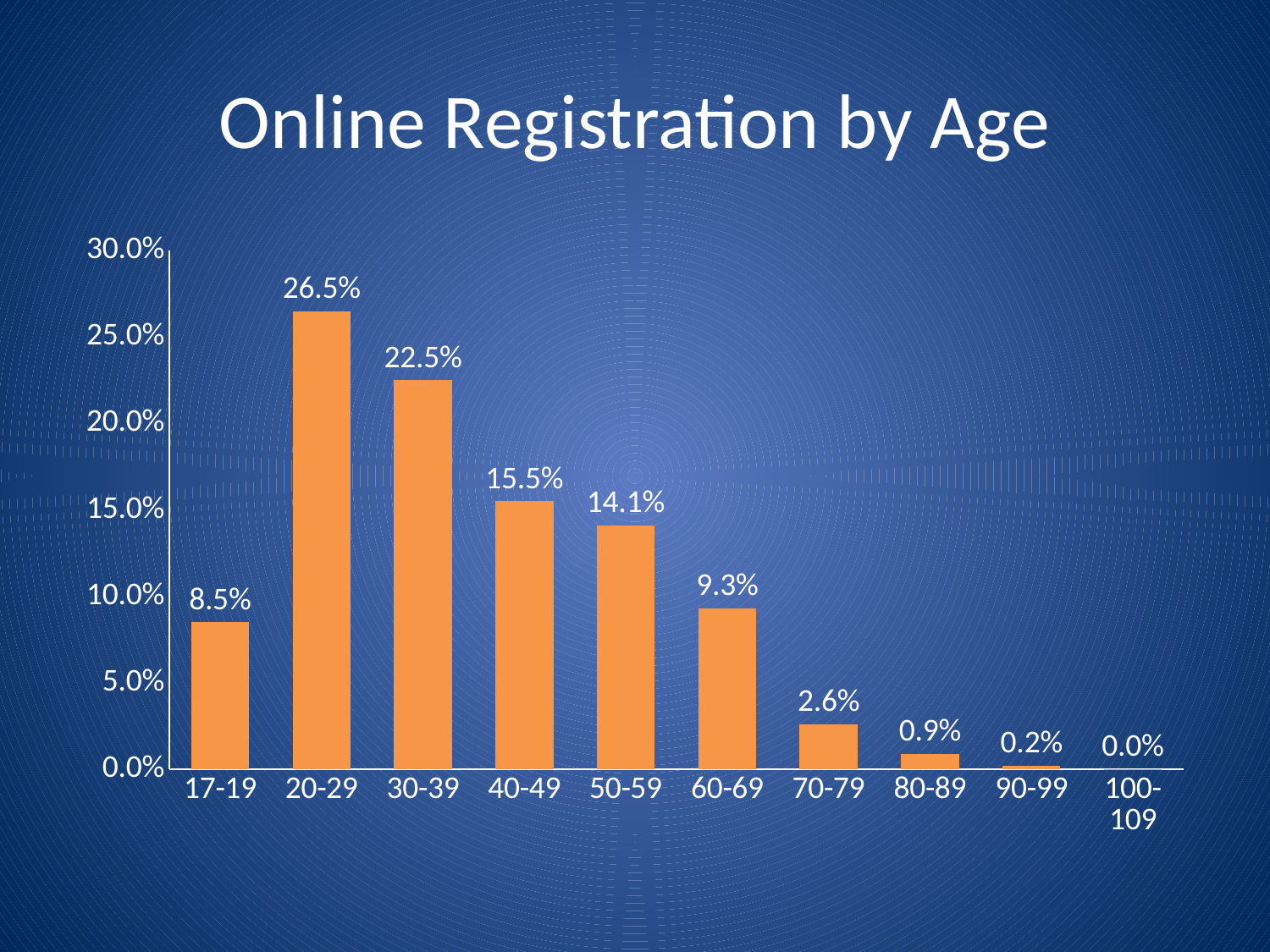
Is the value for the 30-39 age group greater or less than 20.0%? greater Which age group has the lowest online registration percentage? 100-109 What is the value shown for the 90-99 age group? 0.2% What is the online registration percentage for the 20-29 age group? 26.5% How many age groups are shown on the chart? 10 What kind of chart is shown on the slide? Bar chart Which age group has a larger value, 17-19 or 60-69? 60-69 What is the difference between the values for the 40-49 and 50-59 age groups? 1.4% What is the difference between the values for the 20-29 and 30-39 age groups? 4.0% What is the value shown for the 60-69 age group? 9.3% What is the title of the chart? Online Registration by Age Which age group has the highest online registration percentage? 20-29